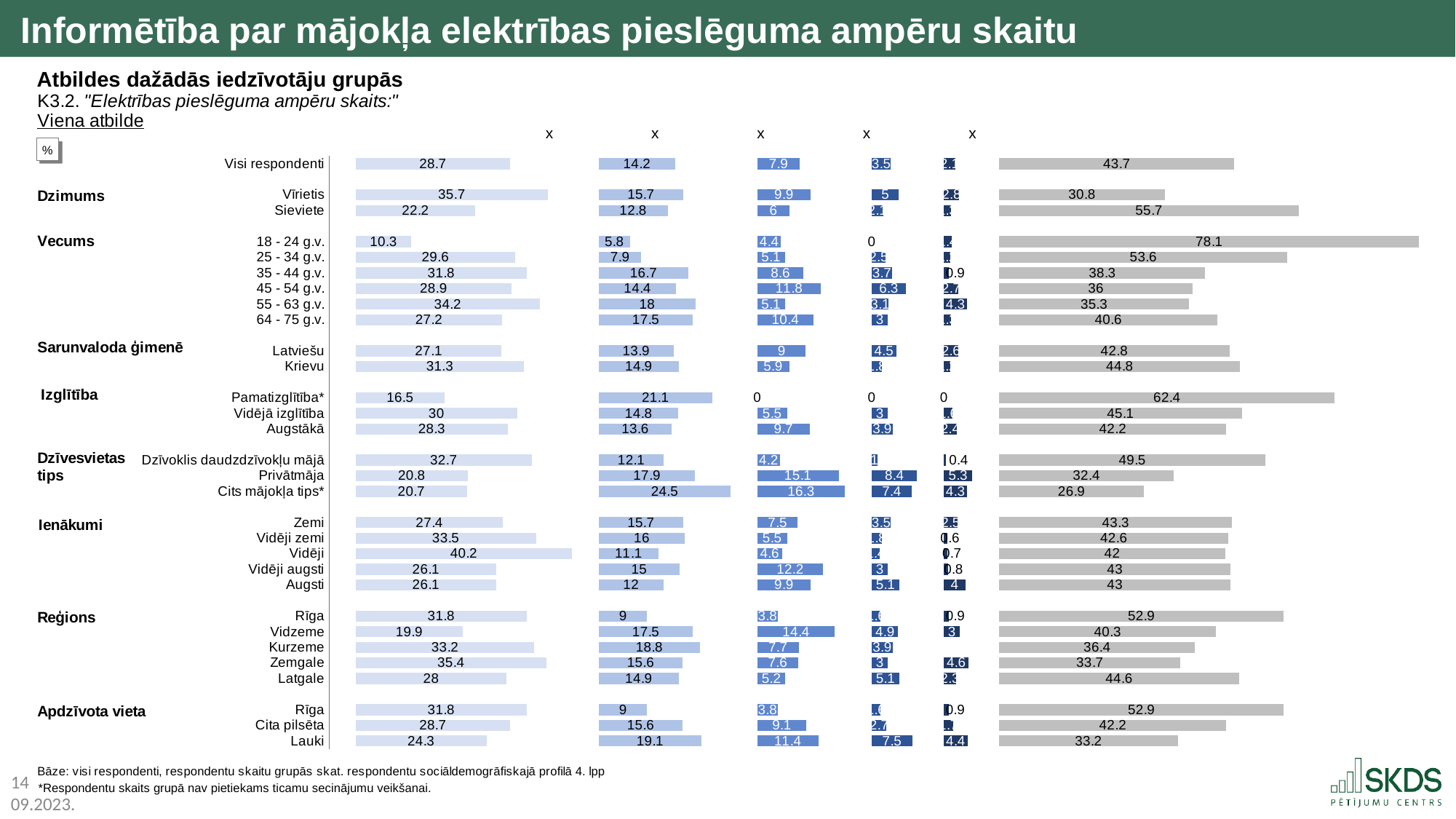
In the rightmost (grey) column of bars, which is larger: 'Vīrietis' or 'Sieviete'? Sieviete What kind of chart is shown on the slide? bar chart What is the value in the leftmost column of bars for 'Vīrietis'? 35.7 What is the value in the rightmost (grey) column of bars for 'Pamatizglītība*'? 62.4 In the leftmost column of bars, what is the difference between 'Vīrietis' and 'Sieviete'? 13.5 What is the value in the second column of bars for 'Privātmāja'? 17.9 Among the 'Ienākumi' rows, which has the highest value in the leftmost column of bars? Vidēji What is the value in the leftmost column of bars for 'Lauki'? 24.3 How many regions are listed under 'Reģions'? 5 Which row has the highest value in the rightmost (grey) column of bars? 18 - 24 g.v. How many age groups are listed under 'Vecums'? 6 What is the value in the rightmost (grey) column of bars for 'Visi respondenti'? 43.7